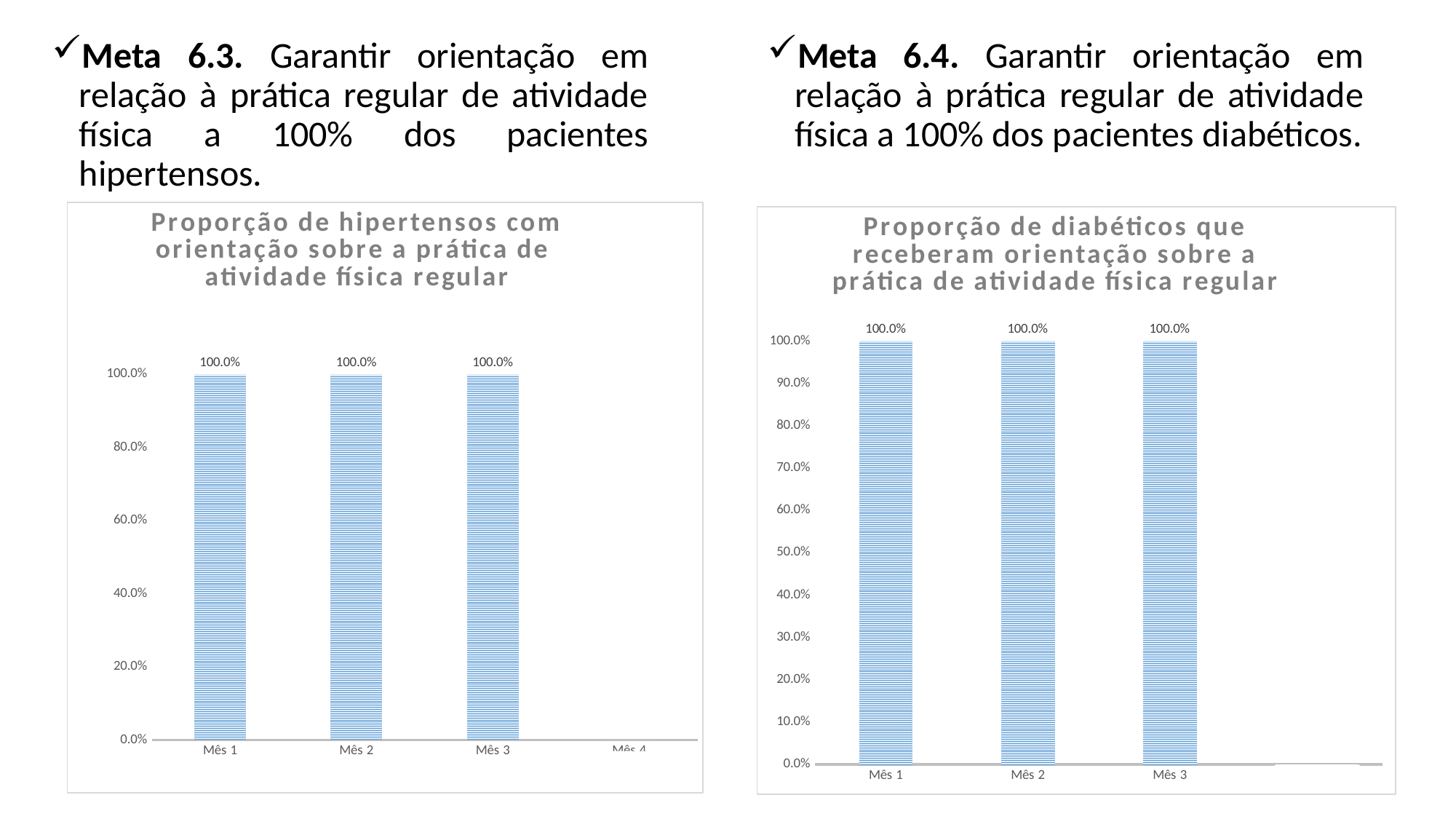
What kind of chart is the left chart (Proporção de hipertensos com orientação sobre a prática de atividade física regular)? Bar chart In the right chart (Proporção de diabéticos que receberam orientação sobre a prática de atividade física regular), what is the value for Mês 2? 100.0% In the right chart (Proporção de diabéticos que receberam orientação sobre a prática de atividade física regular), do the values rise, fall or stay the same from Mês 1 to Mês 3? Stay the same In the left chart (Proporção de hipertensos com orientação sobre a prática de atividade física regular), is the value for Mês 2 greater or less than 80.0%? greater What is the title of the right chart? Proporção de diabéticos que receberam orientação sobre a prática de atividade física regular In the left chart (Proporção de hipertensos com orientação sobre a prática de atividade física regular), what is the value for Mês 3? 100.0% What kind of chart is the right chart (Proporção de diabéticos que receberam orientação sobre a prática de atividade física regular)? Bar chart In the left chart (Proporção de hipertensos com orientação sobre a prática de atividade física regular), how many bars are plotted? 3 In the right chart (Proporção de diabéticos que receberam orientação sobre a prática de atividade física regular), what is the value for Mês 3? 100.0% In the right chart (Proporção de diabéticos que receberam orientação sobre a prática de atividade física regular), how many bars are plotted? 3 In the left chart (Proporção de hipertensos com orientação sobre a prática de atividade física regular), what is the value for Mês 1? 100.0% In the left chart (Proporção de hipertensos com orientação sobre a prática de atividade física regular), what is the difference between the values for Mês 1 and Mês 2? 0.0%